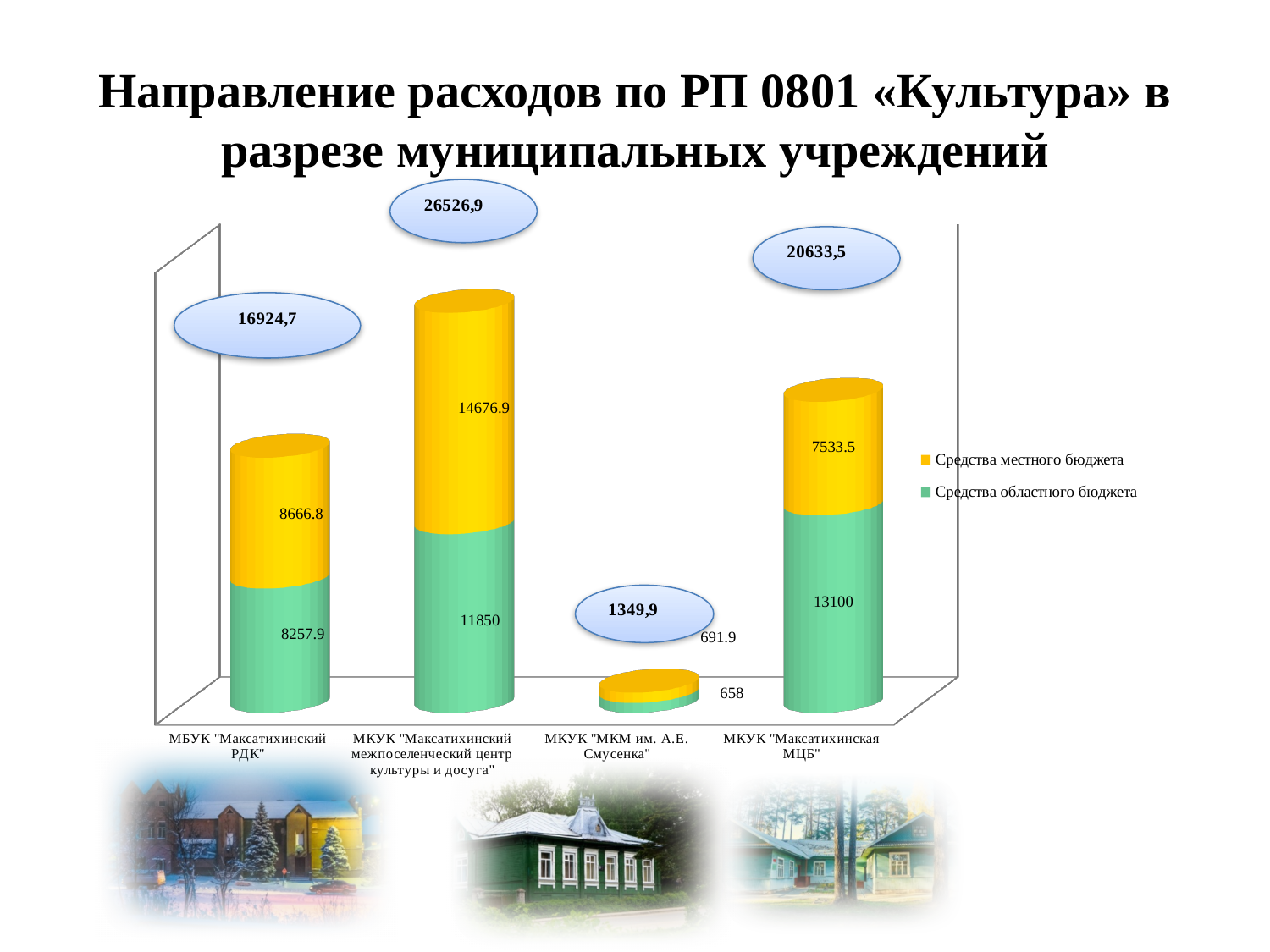
What type of chart is shown on the slide? bar chart What is the difference between "Средства областного бюджета" and "Средства местного бюджета" for МКУК "Максатихинская МЦБ"? 5566.5 Which colour represents "Средства областного бюджета" in the chart? green How many series does the legend list? 2 What is the value of "Средства областного бюджета" for МБУК "Максатихинский РДК"? 8257.9 Which institution has the lowest total expenditure? МКУК "МКМ им. А.Е. Смусенка" Which institution has the highest total expenditure? МКУК "Максатихинский межпоселенческий центр культуры и досуга" What is the total of the stacked bar for МКУК "Максатихинская МЦБ"? 20633,5 What is the value of "Средства областного бюджета" for МКУК "Максатихинская МЦБ"? 13100 How many institutions (categories) are shown on the x axis? 4 What is the value of "Средства местного бюджета" for МКУК "МКМ им. А.Е. Смусенка"? 691.9 What is the value of "Средства местного бюджета" for МКУК "Максатихинский межпоселенческий центр культуры и досуга"? 14676.9